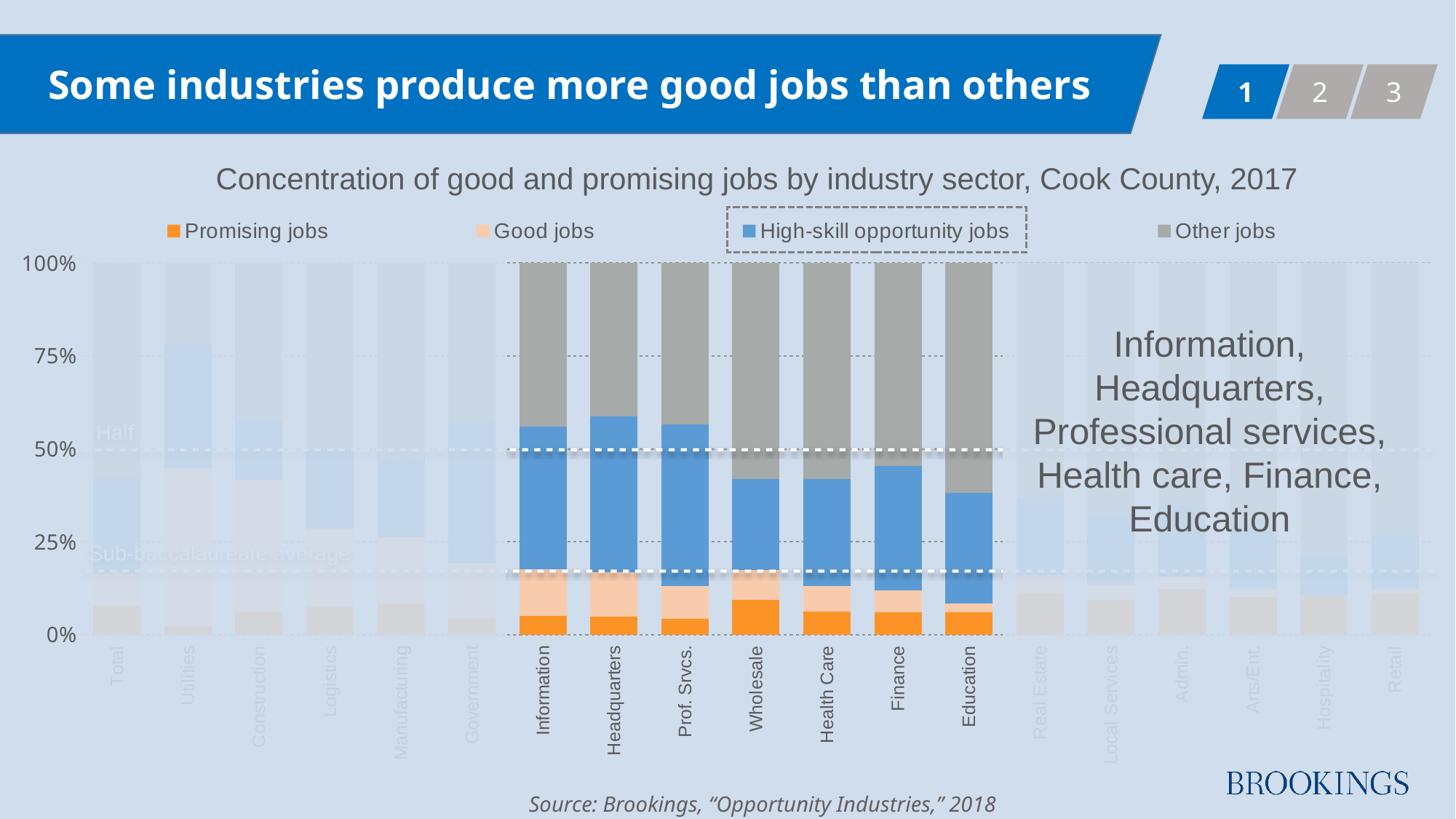
What kind of chart is shown on the slide? Stacked bar chart Is the share of promising jobs for Wholesale greater or less than 25%? less Is the combined share of promising, good and high-skill opportunity jobs for Health Care greater or less than 50%? less Is the combined share of promising, good and high-skill opportunity jobs for Information greater or less than 50%? greater How many series does the legend list? 4 What is the title of the chart? Concentration of good and promising jobs by industry sector, Cook County, 2017 Which has the larger share of promising jobs, Wholesale or Information? Wholesale Among the highlighted industries (Information through Education), which has the lowest combined share of promising, good and high-skill opportunity jobs? Education Which legend entry is outlined with a dashed box? High-skill opportunity jobs How many industry categories are shown along the x axis? 19